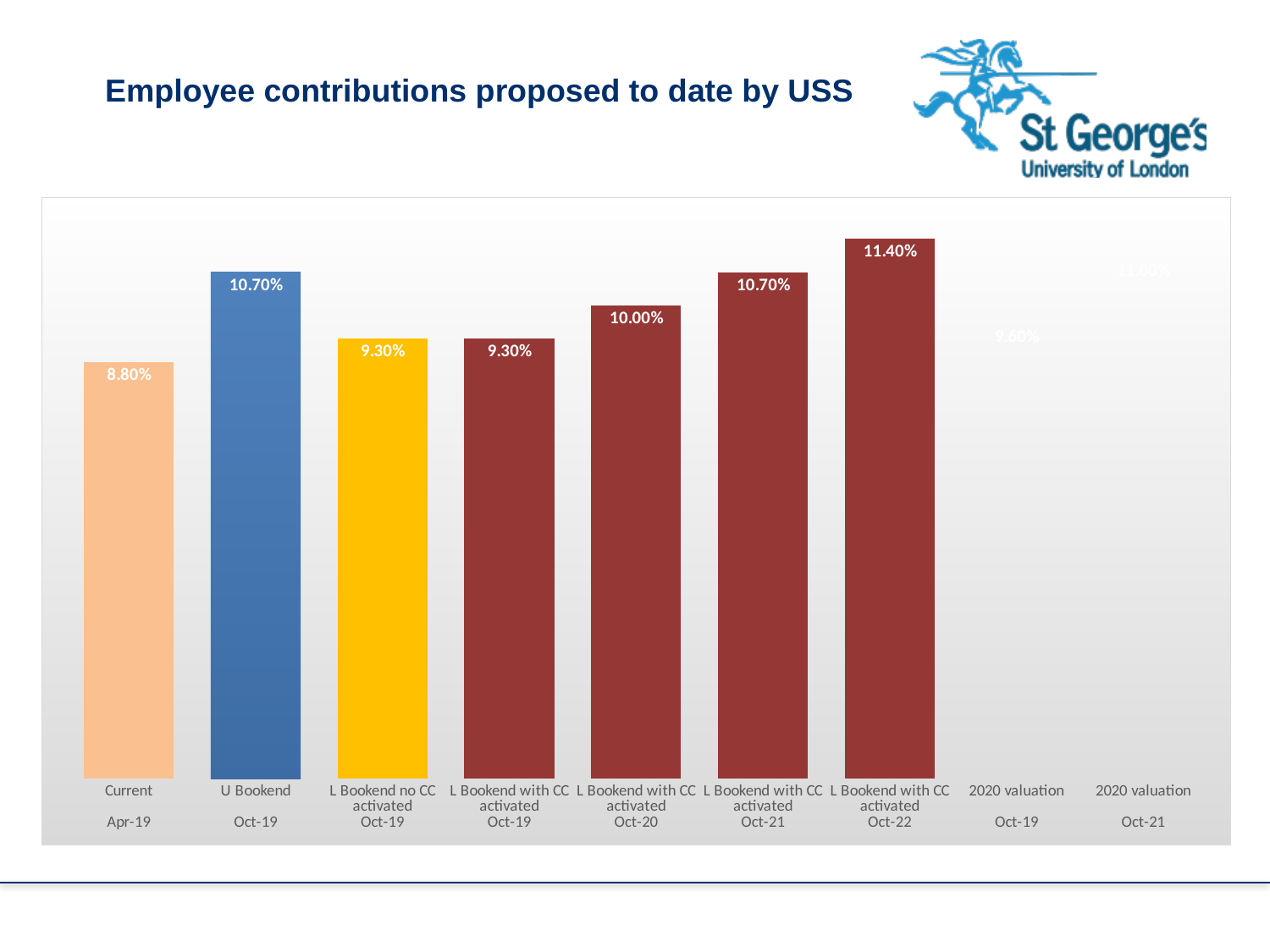
Which bar has the lowest value on the chart? Current, Apr-19 What value is shown for L Bookend with CC activated in Oct-20? 10.00% Which bar has the highest value on the chart? L Bookend with CC activated, Oct-22 What value is shown for U Bookend (Oct-19)? 10.70% What type of chart is shown on the slide? bar chart Which is larger: the U Bookend (Oct-19) value or the L Bookend with CC activated (Oct-20) value? U Bookend (Oct-19) What is the employee contribution value for the Current (Apr-19) bar? 8.80% What is the title of the chart on the slide? Employee contributions proposed to date by USS What value is shown for L Bookend no CC activated (Oct-19)? 9.30% Do the L Bookend with CC activated values rise or fall from Oct-19 to Oct-22? rise What is the difference between the Oct-22 L Bookend with CC activated value and the Current Apr-19 value? 2.60% What value is shown for L Bookend with CC activated in Oct-22? 11.40%